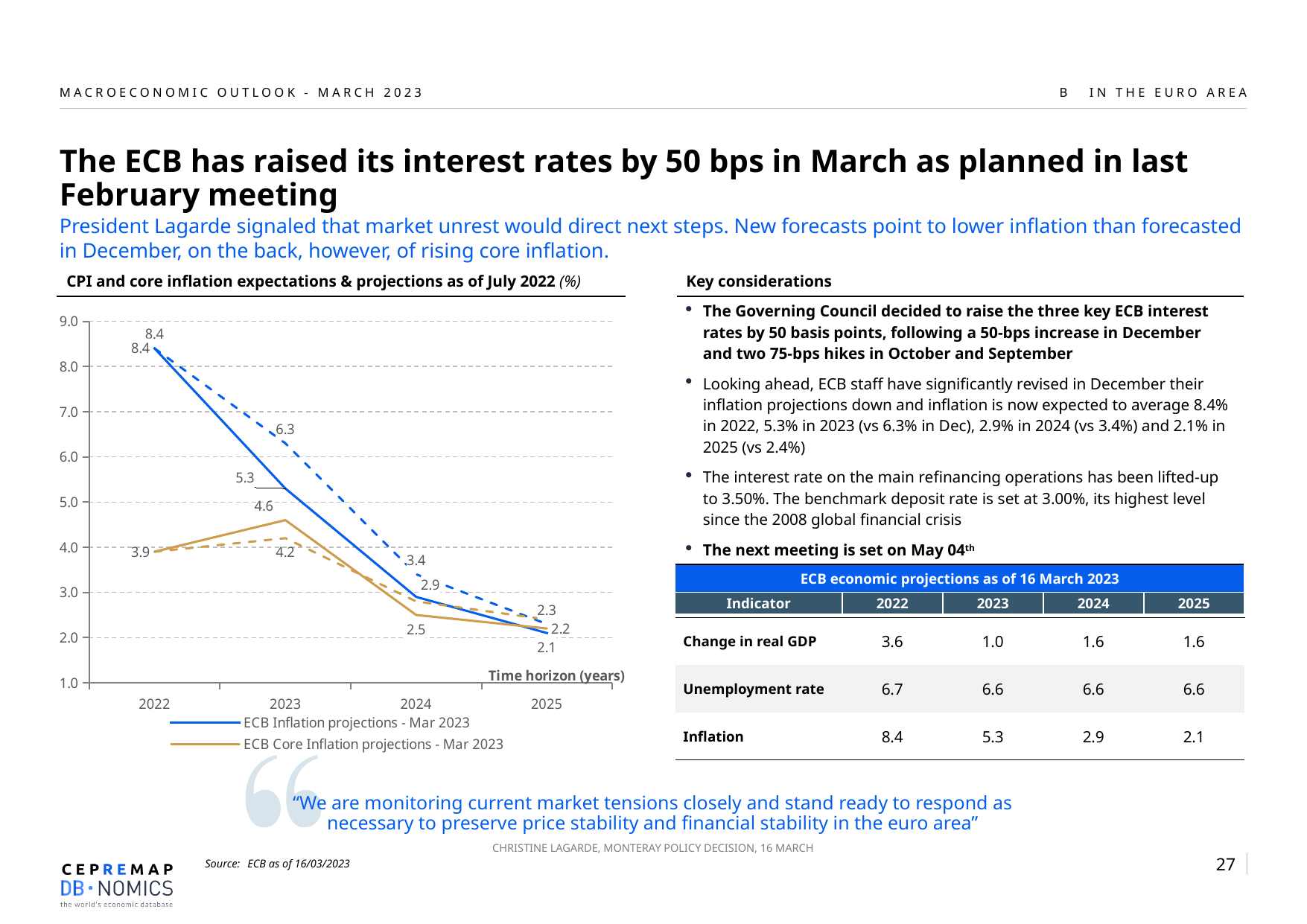
What is the value of ECB Inflation projections - Mar 2023 for 2025? 2.1 What is the value of ECB Core Inflation projections - Mar 2023 for 2022? 3.9 For 2024, which is larger: ECB Inflation projections - Mar 2023 or ECB Core Inflation projections - Mar 2023? ECB Inflation projections - Mar 2023 What kind of chart is shown on the slide? line chart Does the ECB Inflation projections - Mar 2023 series rise or fall from 2022 to 2025? fall What is the value of ECB Inflation projections - Mar 2023 for 2022? 8.4 What is the difference between the ECB Inflation projections - Mar 2023 values for 2022 and 2023? 3.1 How many series does the chart legend list? 2 In which year is the ECB Inflation projections - Mar 2023 series at its highest? 2022 What is the value of ECB Core Inflation projections - Mar 2023 for 2023? 4.6 How many years are shown on the x axis of the chart? 4 What is the value of ECB Inflation projections - Mar 2023 for 2023? 5.3